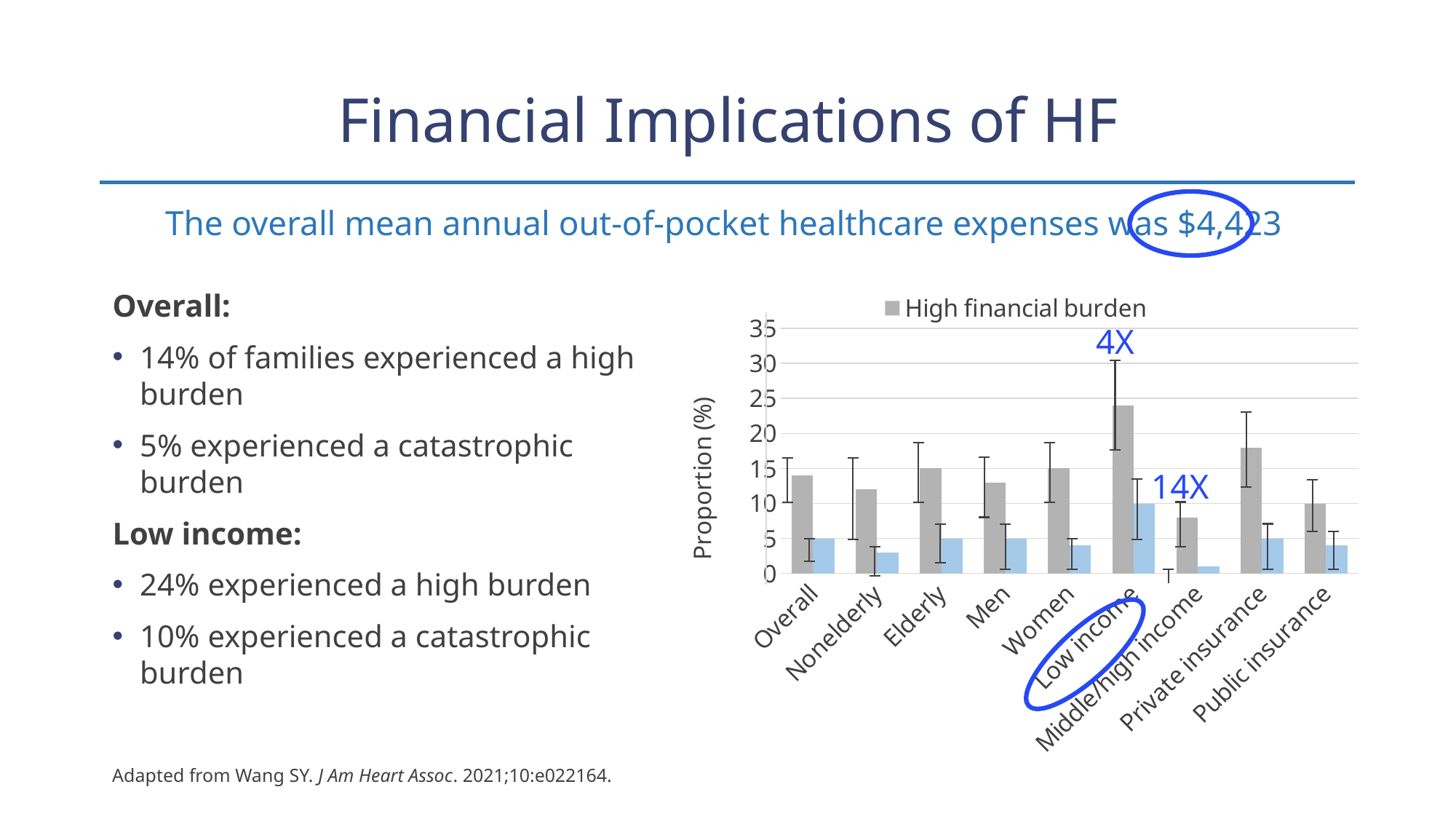
Which has the larger High financial burden bar, Private insurance or Public insurance? Private insurance Which category has the highest High financial burden (gray) bar? Low income Is the High financial burden value for Low income greater or less than 20? greater Is the High financial burden value for Private insurance greater or less than 15? greater What kind of chart is shown on the slide? bar chart What is the label on the y axis of the chart? Proportion (%) Which category has the tallest blue bar in the chart? Low income Is the blue bar value for Nonelderly greater or less than 5? less How many categories are shown along the x axis of the chart? 9 How many series does the chart's legend list? 1 Which category has the lowest blue bar in the chart? Middle/high income